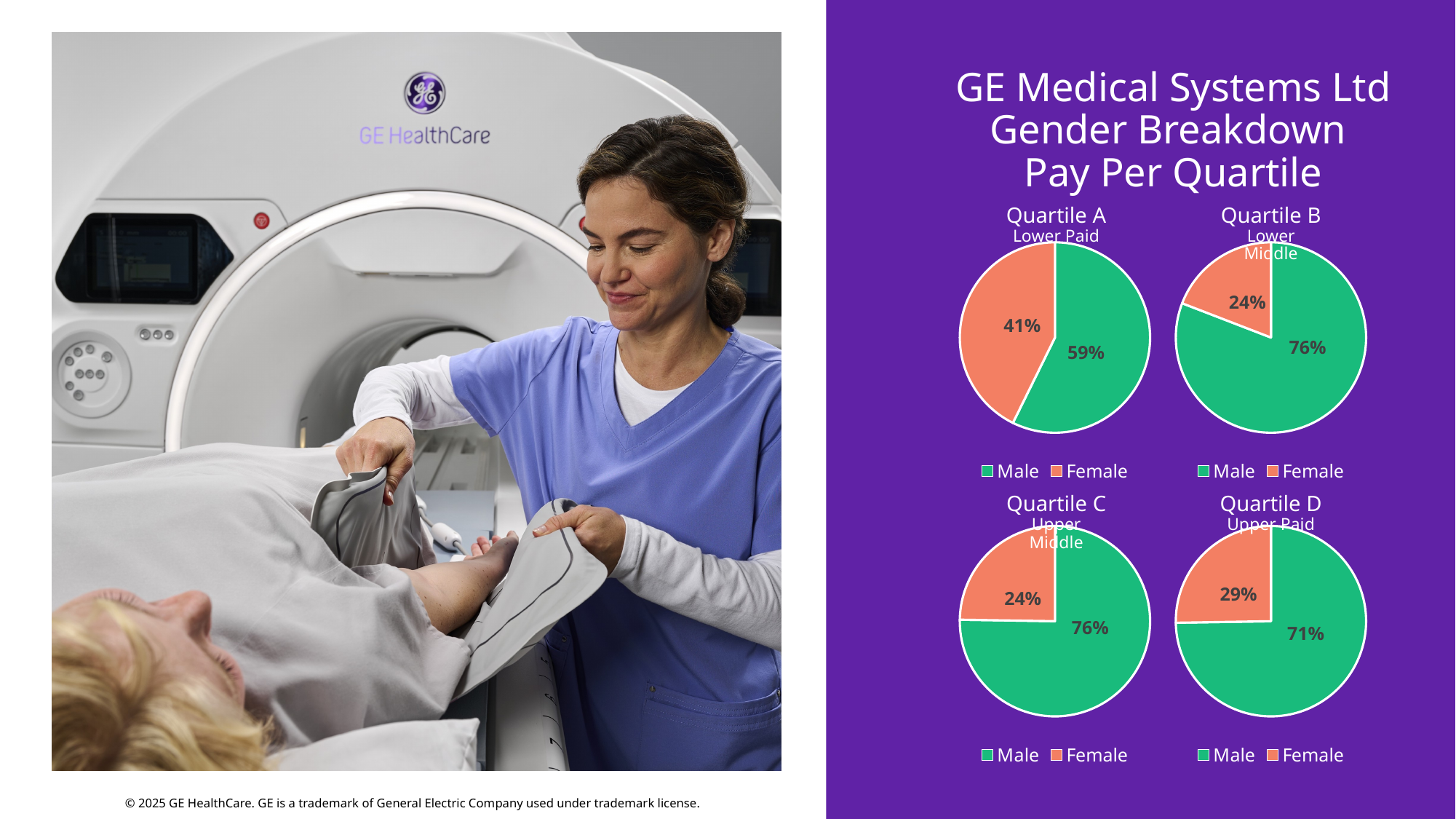
In the Quartile C (Upper Middle) pie chart, what percentage is Male? 76% In the Quartile A (Lower Paid) pie chart, what is the difference between the Male and Female percentages? 18% In the Quartile D (Upper Paid) pie chart, which slice is larger, Male or Female? Male In the Quartile D (Upper Paid) pie chart, what percentage is Female? 29% How many series does the legend of the Quartile B (Lower Middle) pie chart list? 2 In the Quartile B (Lower Middle) pie chart, what percentage is Female? 24% In the Quartile A (Lower Paid) pie chart, what percentage is Male? 59% How many pie charts are shown on the slide? 4 In the Quartile A (Lower Paid) pie chart, what percentage is Female? 41% What kind of chart is used for each quartile on the slide? Pie chart Which quartile pie chart has the highest Female percentage? Quartile A (Lower Paid) In the Quartile D (Upper Paid) pie chart, what is the difference between the Male and Female percentages? 42%